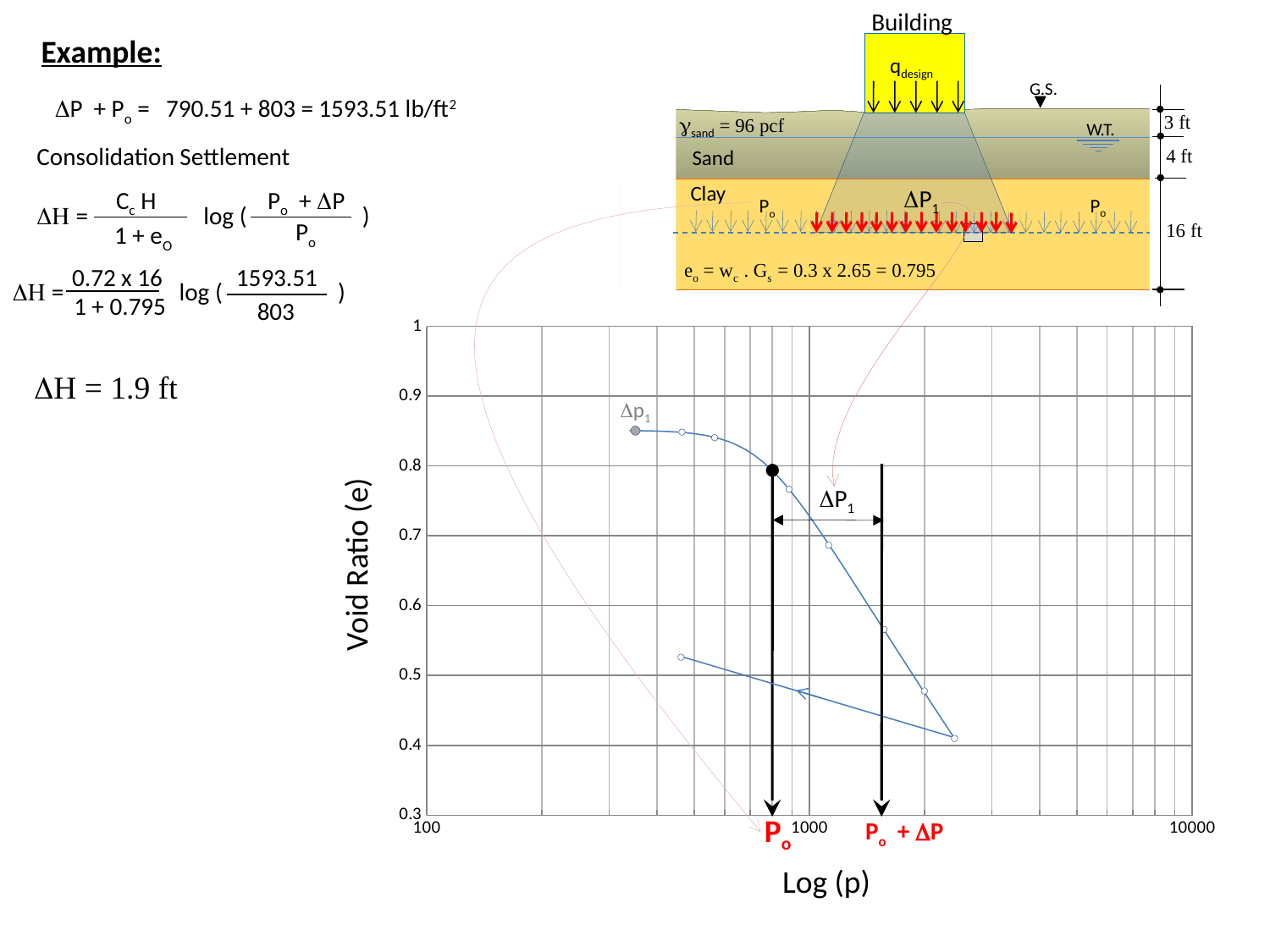
What kind of chart is shown on the slide? line chart Along the loading curve, does the void ratio rise or fall as p increases? fall What is the highest value labelled on the vertical axis of the chart? 1 Is the void ratio where the curve crosses the Po + ΔP line greater or less than 0.7? less What is the lowest value labelled on the vertical axis of the chart? 0.3 What is the largest value labelled on the horizontal axis of the chart? 10000 What is the title of the vertical axis of the chart? Void Ratio (e) Is the void ratio at the point labelled Δp1 greater or less than 0.8? greater What is the title of the horizontal axis of the chart? Log (p) How many values are labelled on the vertical axis of the chart? 8 What is the smallest value labelled on the horizontal axis of the chart? 100 Is the lowest void ratio reached by the curve greater or less than 0.5? less